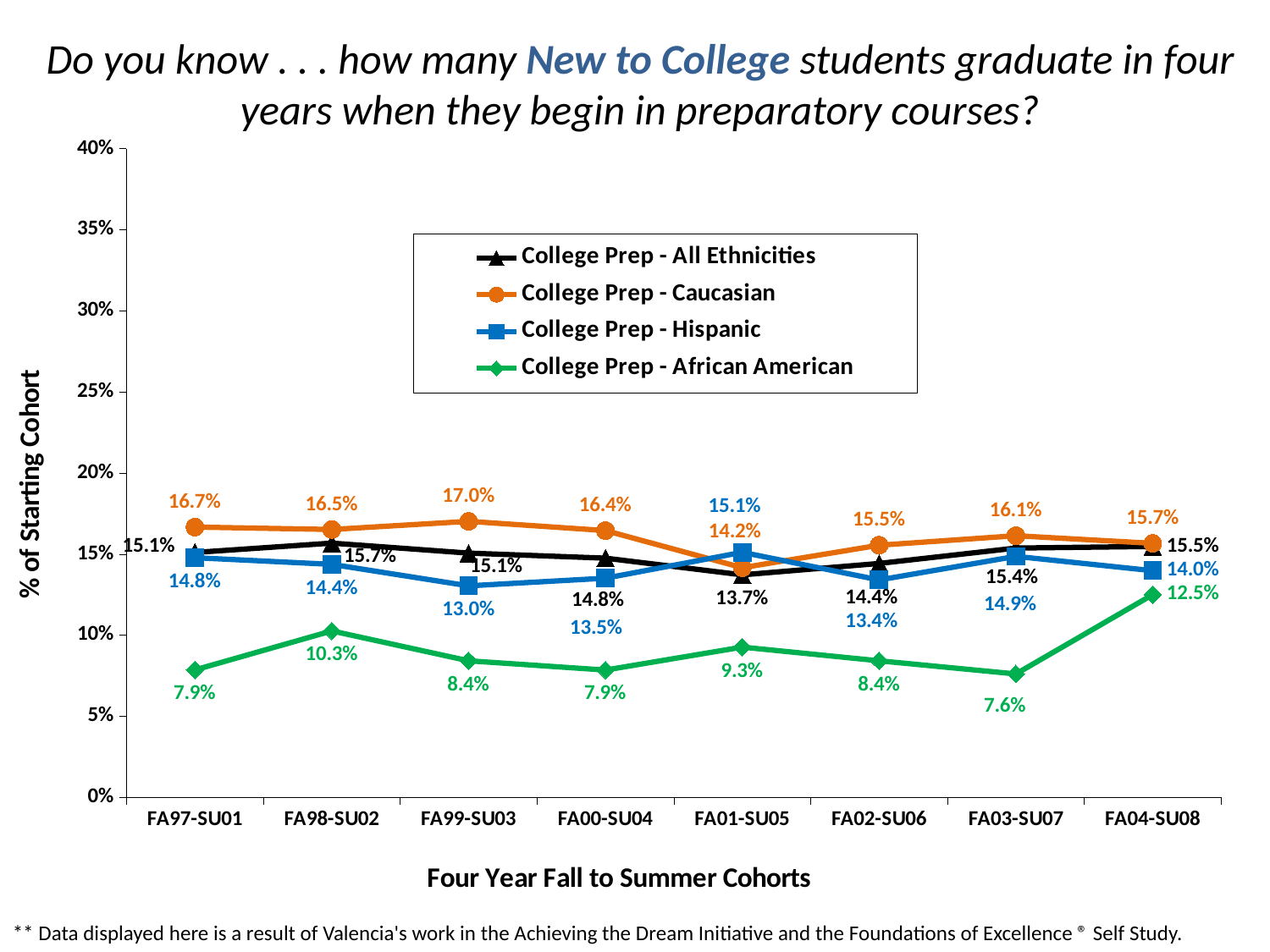
What is the difference between College Prep - Caucasian and College Prep - African American in the FA97-SU01 cohort? 8.8 percentage points What is the title of the y axis? % of Starting Cohort What is the value for College Prep - Caucasian in the FA99-SU03 cohort? 17.0% How many series does the legend list? 4 In which cohort does College Prep - African American have its lowest value? FA03-SU07 What is the value for College Prep - All Ethnicities in the FA01-SU05 cohort? 13.7% How many cohorts are shown on the x axis? 8 In which cohort does College Prep - Caucasian reach its highest value? FA99-SU03 Is the value for College Prep - African American in the FA03-SU07 cohort greater or less than 10%? less What kind of chart is shown on the slide? Line chart In the FA01-SU05 cohort, which is higher: College Prep - Hispanic or College Prep - Caucasian? College Prep - Hispanic What is the value for College Prep - African American in the FA04-SU08 cohort? 12.5%